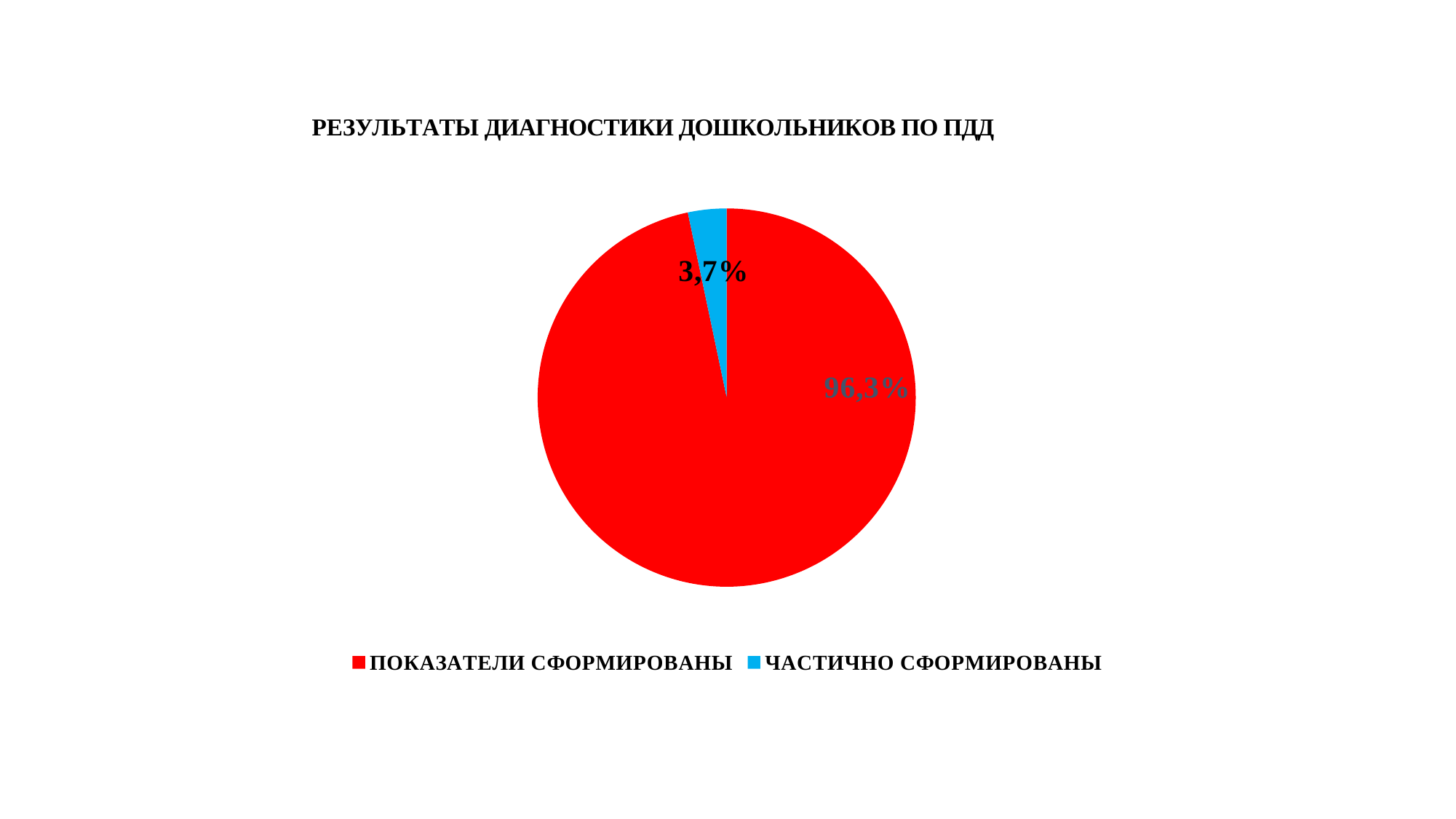
What colour is the slice for ЧАСТИЧНО СФОРМИРОВАНЫ? blue How many slices does the pie chart have? 2 What is the total of the two slice percentages shown on the pie? 100% What share of the pie is labelled for ПОКАЗАТЕЛИ СФОРМИРОВАНЫ? 96,3% Which is larger: the slice for ПОКАЗАТЕЛИ СФОРМИРОВАНЫ or the slice for ЧАСТИЧНО СФОРМИРОВАНЫ? ПОКАЗАТЕЛИ СФОРМИРОВАНЫ What is the difference in percentage points between the ПОКАЗАТЕЛИ СФОРМИРОВАНЫ slice and the ЧАСТИЧНО СФОРМИРОВАНЫ slice? 92,6% How many entries does the legend list? 2 What kind of chart is shown on the slide? pie chart What share of the pie is labelled for ЧАСТИЧНО СФОРМИРОВАНЫ? 3,7% Which category has the largest slice of the pie? ПОКАЗАТЕЛИ СФОРМИРОВАНЫ Which category has the smallest slice of the pie? ЧАСТИЧНО СФОРМИРОВАНЫ What is the title of the chart? РЕЗУЛЬТАТЫ ДИАГНОСТИКИ ДОШКОЛЬНИКОВ ПО ПДД